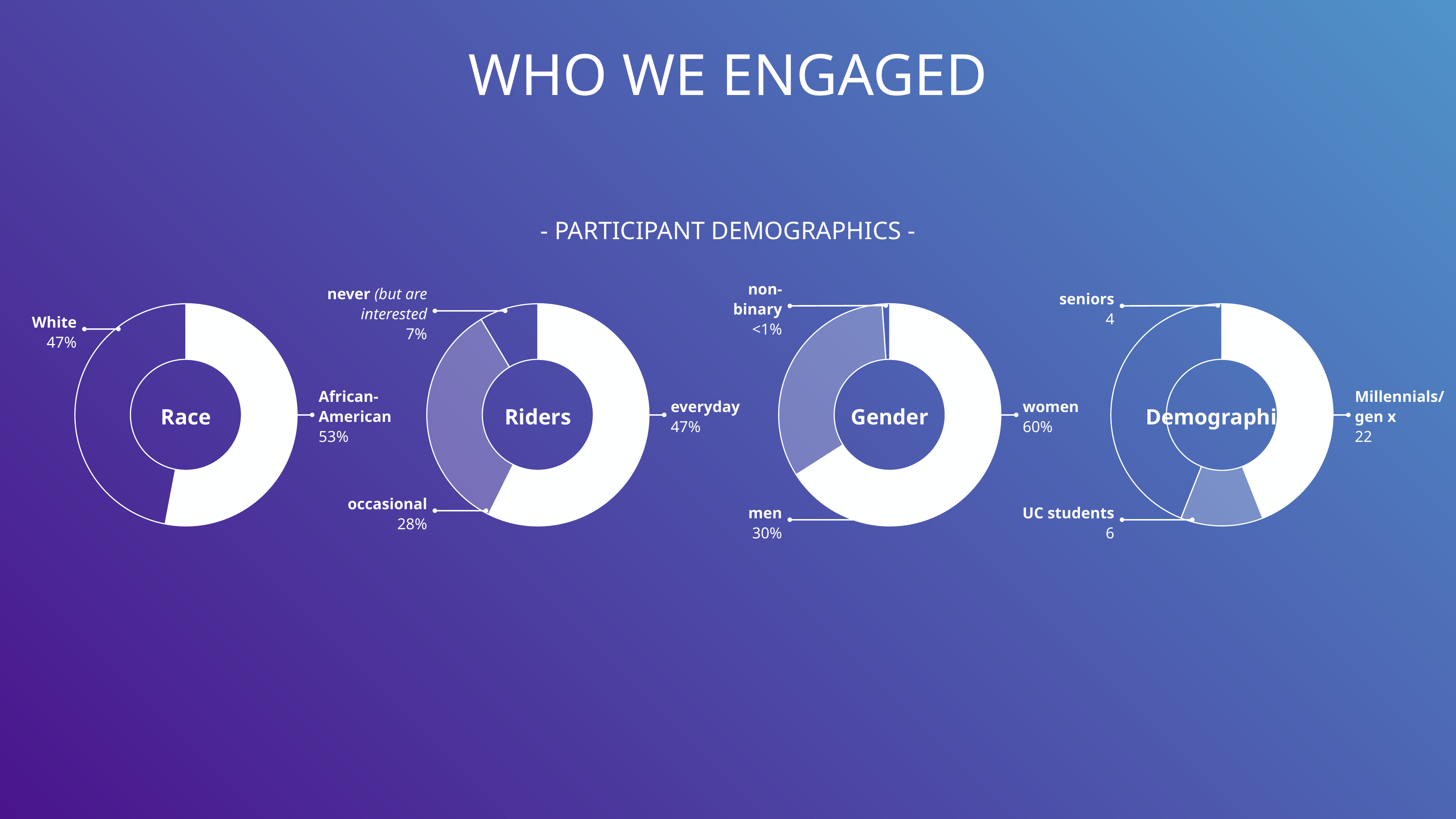
In the Race chart, what percentage is White? 47% What kind of chart is used for the Gender chart? Donut (pie) chart In the Riders chart, which category has the smallest share? never (but are interested) In the Gender chart, what percentage are women? 60% In the Race chart, what is the difference between the African-American and White percentages? 6% In the Race chart, what percentage is African-American? 53% In the Gender chart, what is the difference between the women and men percentages? 30% In the Riders chart, what percentage are occasional riders? 28% In the Riders chart, which category has the largest share? everyday In the Demographic chart, what is the value for UC students? 6 In the Demographic chart, which category has the highest value? Millennials/gen x In the Race chart, which category has the larger share, White or African-American? African-American